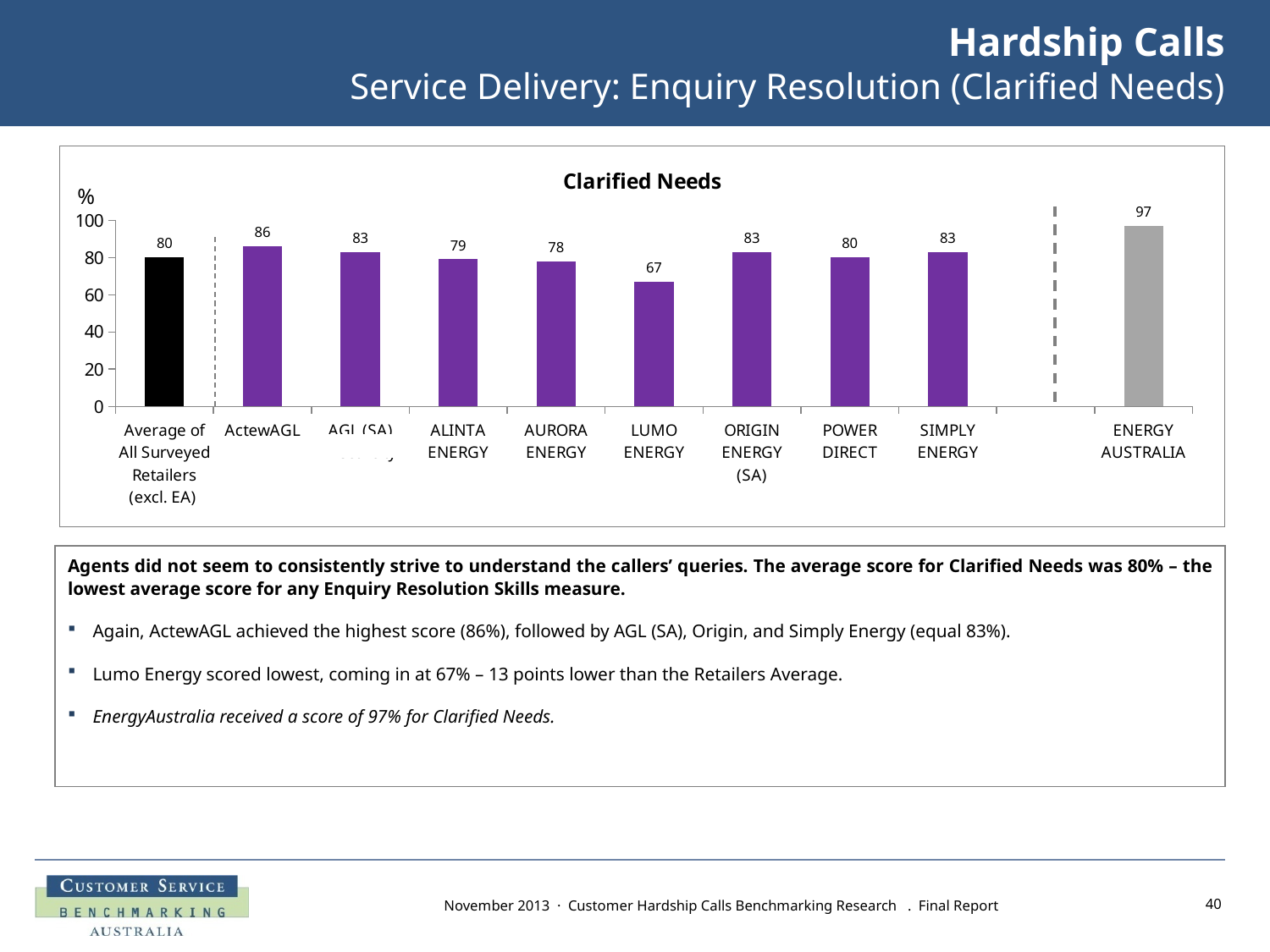
What is the difference between the values for Energy Australia and the Average of All Surveyed Retailers (excl. EA) in the Clarified Needs chart? 17 Which category has the highest value in the Clarified Needs chart? Energy Australia What is the value for Energy Australia in the Clarified Needs chart? 97 What is the title of the chart on the slide? Clarified Needs What is the value for Lumo Energy in the Clarified Needs chart? 67 What is the value for Average of All Surveyed Retailers (excl. EA) in the Clarified Needs chart? 80 Which category has the lowest value in the Clarified Needs chart? Lumo Energy In the Clarified Needs chart, which is larger: the value for Alinta Energy or the value for Aurora Energy? Alinta Energy How many bars are plotted in the Clarified Needs chart? 10 What is the value for ActewAGL in the Clarified Needs chart? 86 What kind of chart is the Clarified Needs chart? Bar chart What is the difference between the values for ActewAGL and Lumo Energy in the Clarified Needs chart? 19